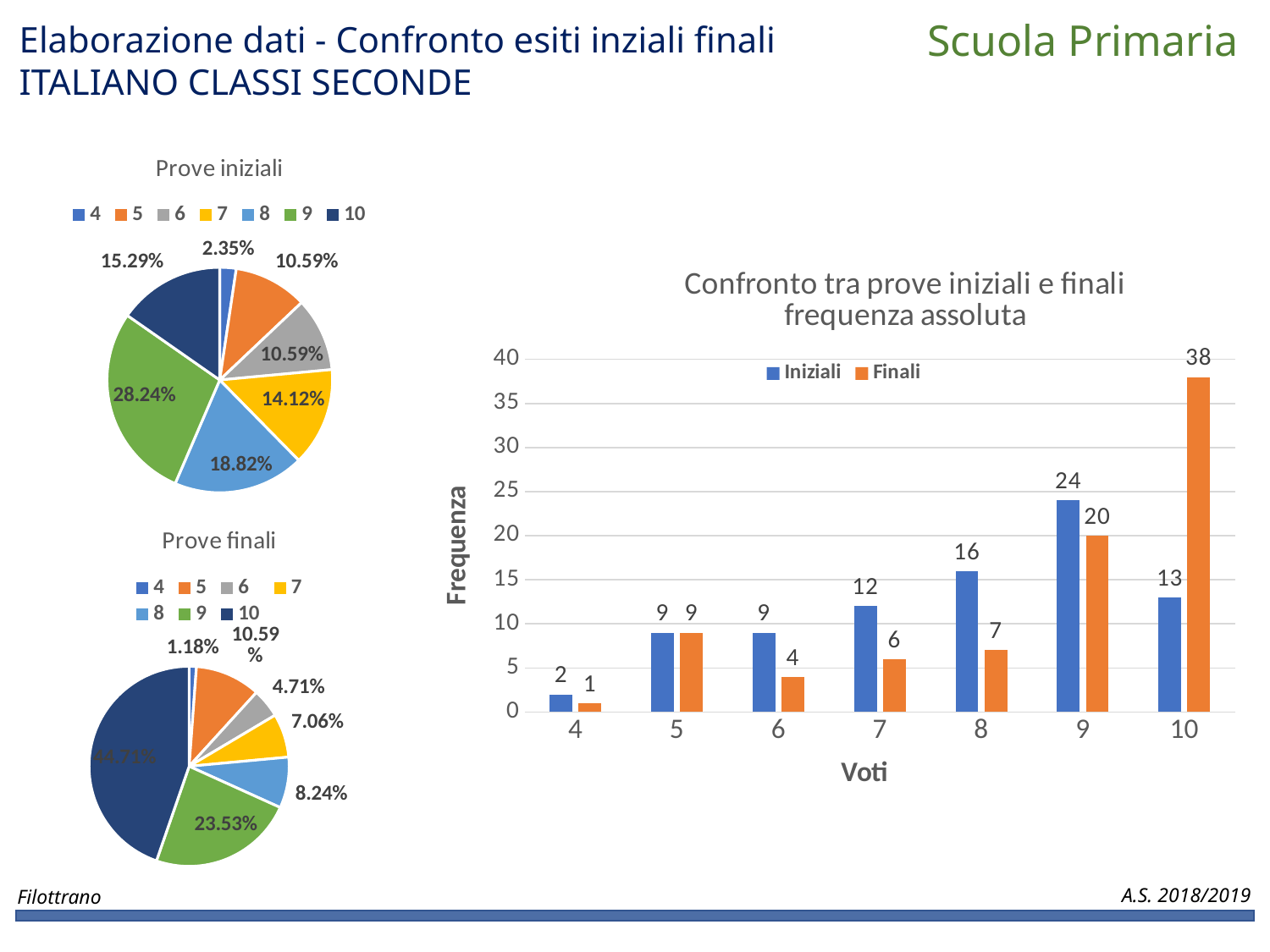
In the bar chart 'Confronto tra prove iniziali e finali frequenza assoluta', which is larger for voto 6: Iniziali or Finali? Iniziali In the 'Prove iniziali' pie chart, what share does voto 9 have? 28.24% In the bar chart 'Confronto tra prove iniziali e finali frequenza assoluta', what is the difference between the Finali and Iniziali values for voto 10? 25 In the 'Prove finali' pie chart, what share does voto 9 have? 23.53% In the 'Prove iniziali' pie chart, which voto has the smallest slice? 4 In the bar chart 'Confronto tra prove iniziali e finali frequenza assoluta', what is the Finali value for voto 10? 38 What type of chart is 'Confronto tra prove iniziali e finali frequenza assoluta'? Bar chart How many series does the legend of the bar chart 'Confronto tra prove iniziali e finali frequenza assoluta' list? 2 In the bar chart 'Confronto tra prove iniziali e finali frequenza assoluta', what is the Iniziali value for voto 8? 16 In the bar chart 'Confronto tra prove iniziali e finali frequenza assoluta', which voto has the highest Iniziali value? 9 In the bar chart 'Confronto tra prove iniziali e finali frequenza assoluta', which voto has the lowest Finali value? 4 How many voti categories are shown on the x axis of the bar chart 'Confronto tra prove iniziali e finali frequenza assoluta'? 7